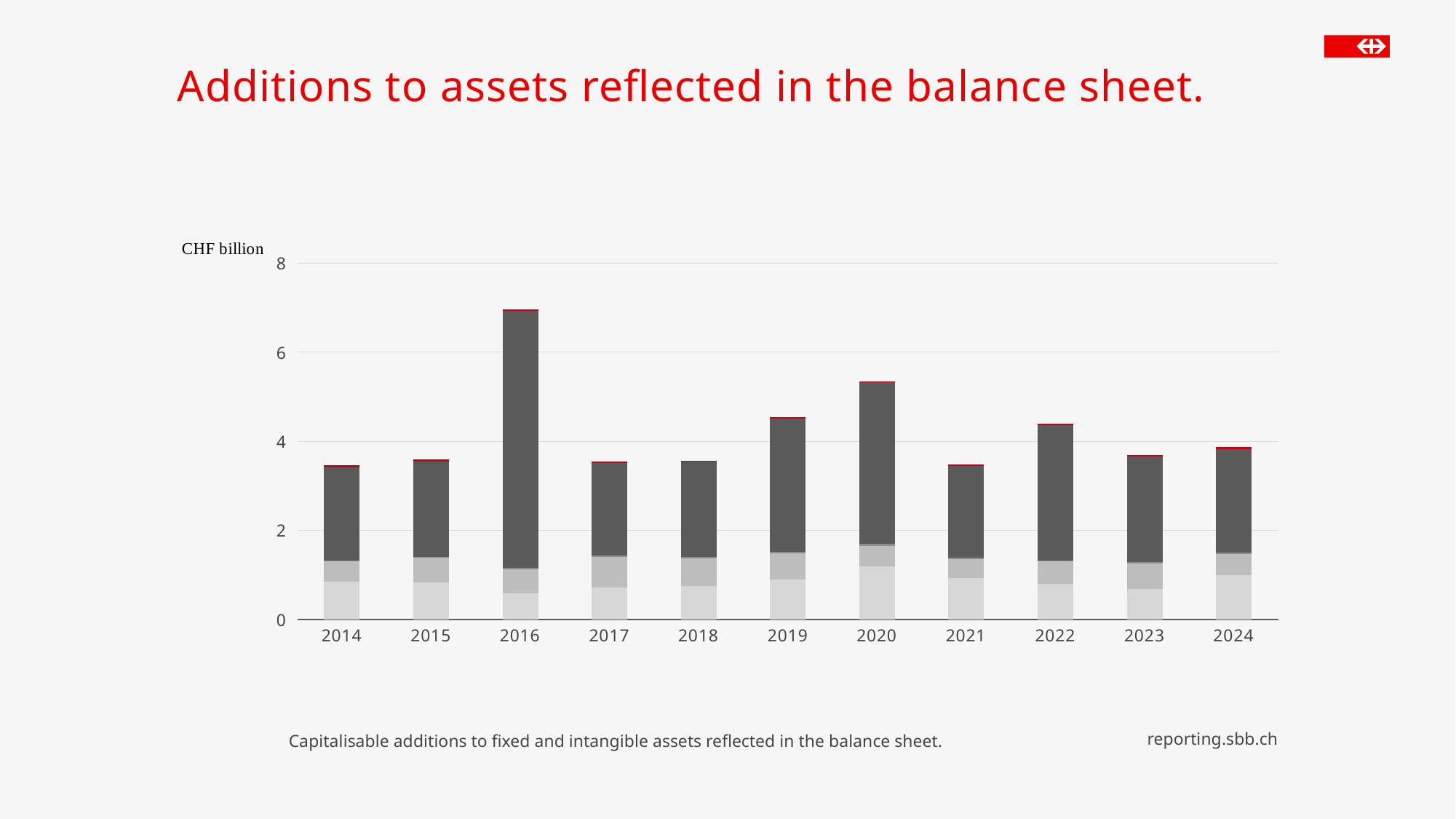
Which year has the larger total, 2019 or 2020? 2020 Is the total value for 2016 greater or less than 6? greater What unit is shown on the y axis of the chart? CHF billion Is the total value for 2019 greater or less than 4? greater Is the total value for 2018 greater or less than 4? less Which year has the highest total additions to assets? 2016 Which year has the larger total, 2021 or 2022? 2022 What kind of chart is shown on the slide? Stacked bar chart How many years are shown on the x axis of the chart? 11